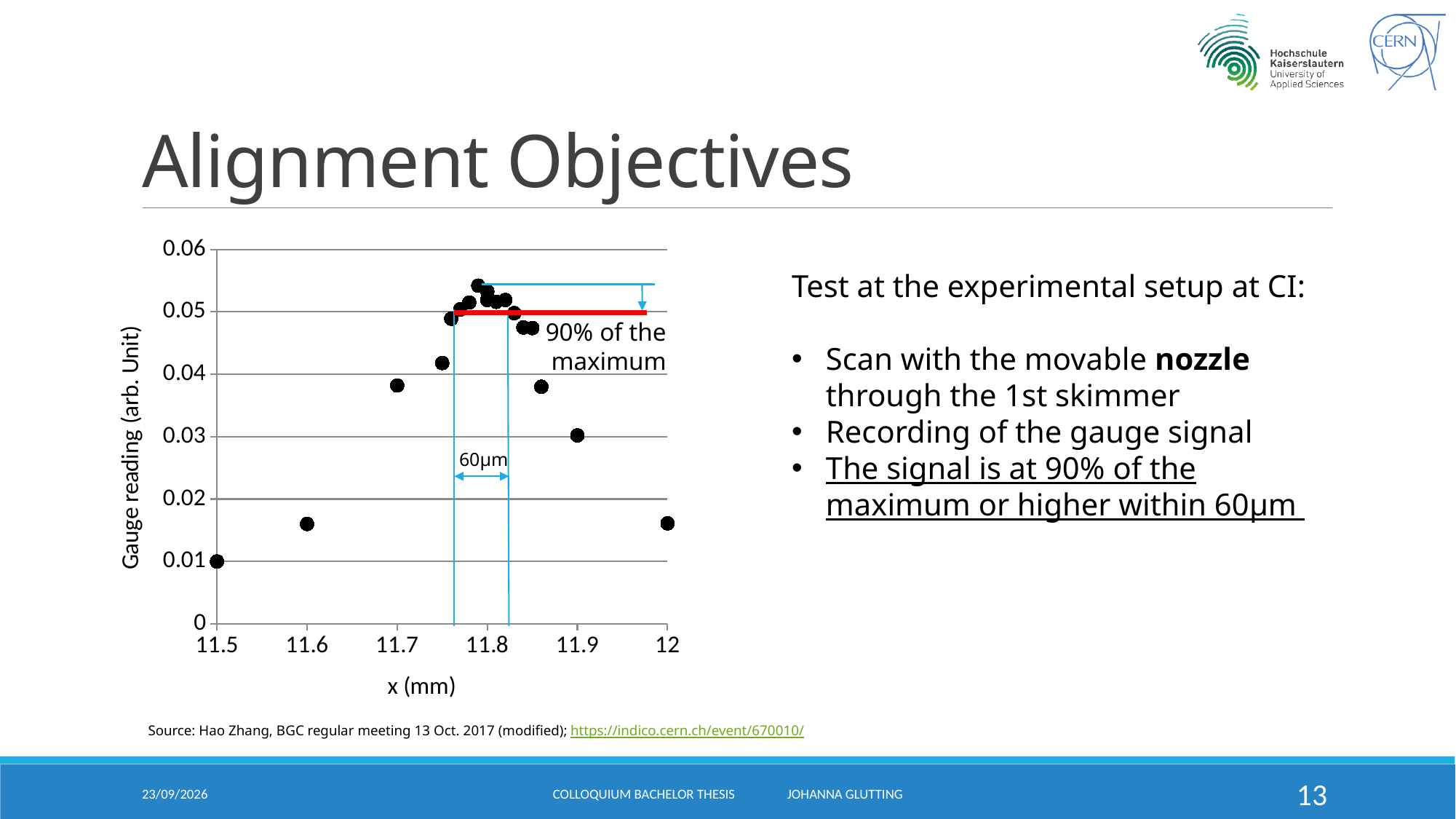
What is the label of the x axis of the chart? x (mm) Is the gauge reading at x = 12 greater or less than 0.02? less Is the gauge reading at x = 11.9 greater or less than 0.04? less What is the label of the y axis of the chart? Gauge reading (arb. Unit) Is the gauge reading at x = 11.6 greater or less than 0.02? less What kind of chart is shown on the slide? scatter chart Do the gauge readings rise or fall as x increases from 11.5 to 11.7? rise Which has the larger gauge reading, x = 11.6 or x = 11.7? x = 11.7 Do the gauge readings rise or fall as x increases from 11.9 to 12? fall